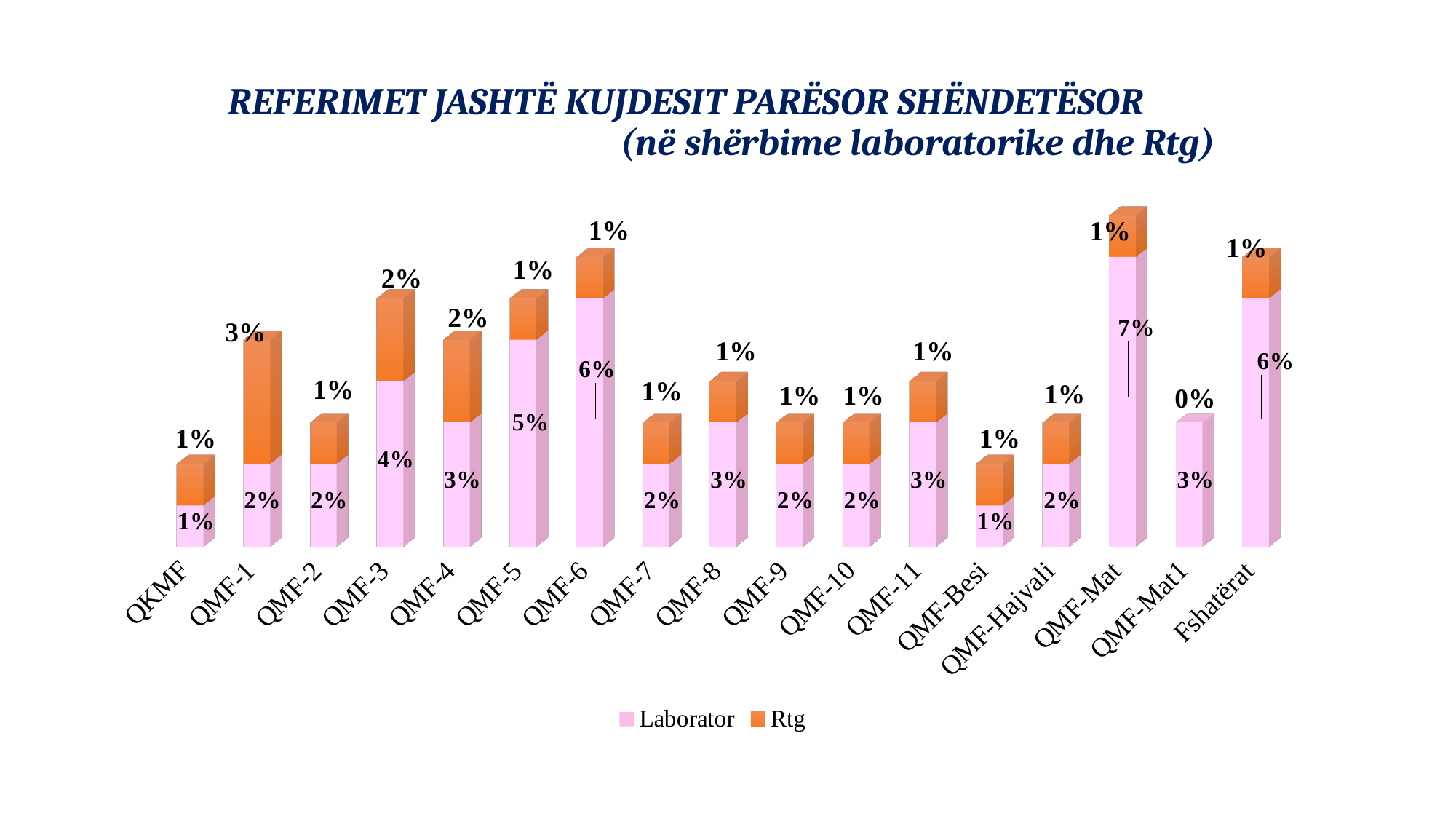
How many categories are shown on the x axis? 17 What is the Laborator value for QMF-3? 4% How many series does the legend list? 2 What is the Rtg value for QMF-1? 3% What is the Laborator value for QMF-Mat? 7% Which category has the lowest Rtg value? QMF-Mat1 Which category has the highest Laborator value? QMF-Mat Which is larger, the Laborator value for QMF-5 or the Laborator value for QMF-8? QMF-5 What is the difference between the Laborator values for QMF-6 and QMF-7? 4% Which category has the highest Rtg value? QMF-1 What kind of chart is shown on the slide? Stacked bar chart What is the total of the stacked bar for QMF-Mat? 8%